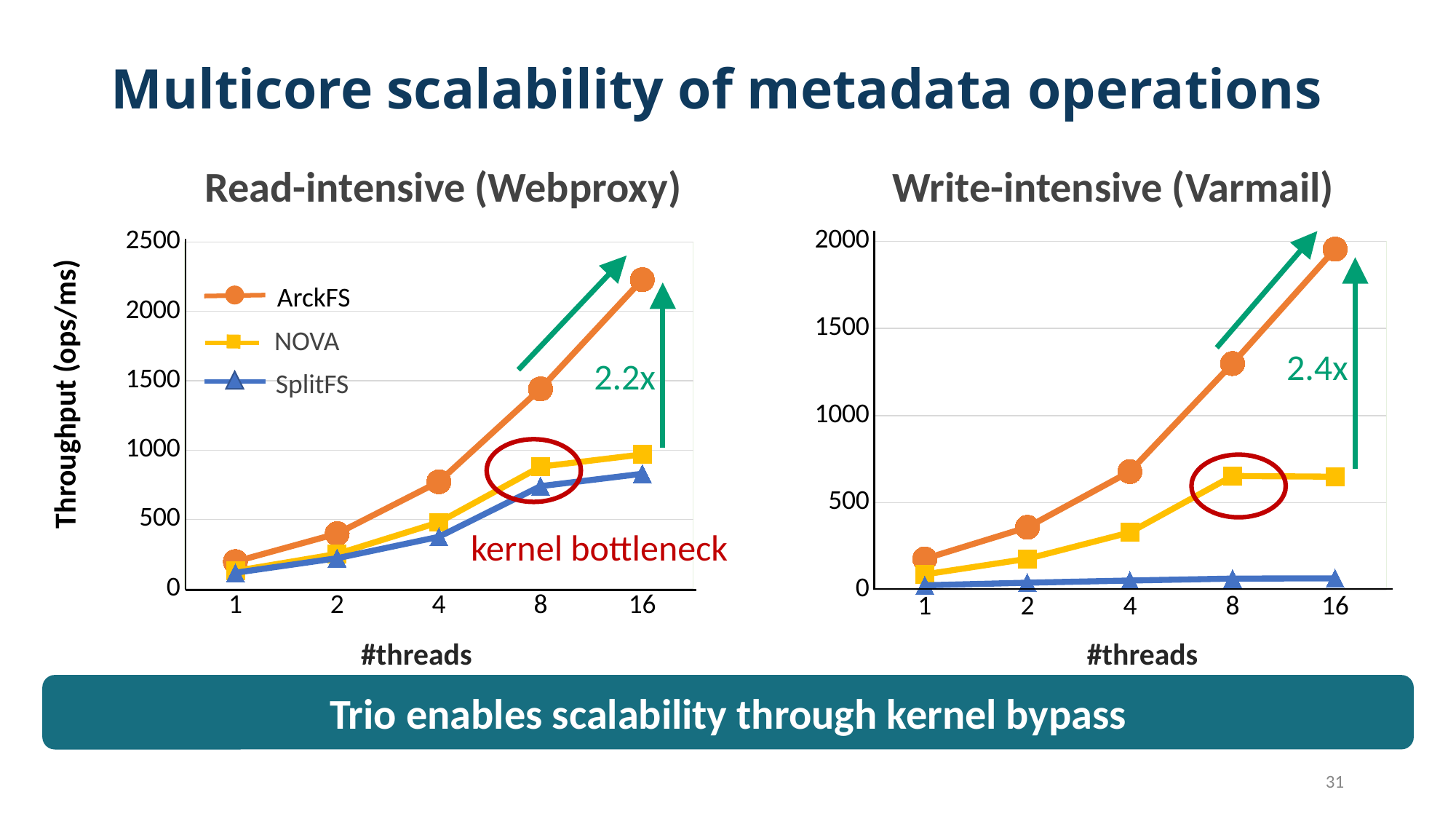
How many series does the legend on the Read-intensive (Webproxy) chart list? 3 What kind of chart is the Read-intensive (Webproxy) chart? line chart In the Read-intensive (Webproxy) chart, is the NOVA throughput at 16 threads greater or less than 1500? less How many thread counts are plotted along the x axis of the Write-intensive (Varmail) chart? 5 In the Read-intensive (Webproxy) chart, does the ArckFS throughput rise or fall as the number of threads increases? rise In the Read-intensive (Webproxy) chart, which series has the highest throughput at 16 threads? ArckFS What speedup factor is annotated on the Write-intensive (Varmail) chart? 2.4x In the Write-intensive (Varmail) chart, is the SplitFS throughput at 16 threads greater or less than 500? less In the Write-intensive (Varmail) chart, which series has the lowest throughput at 16 threads? SplitFS In the Read-intensive (Webproxy) chart, is the ArckFS throughput at 16 threads greater or less than 2000? greater In the Write-intensive (Varmail) chart, which is larger at 16 threads: NOVA or SplitFS? NOVA